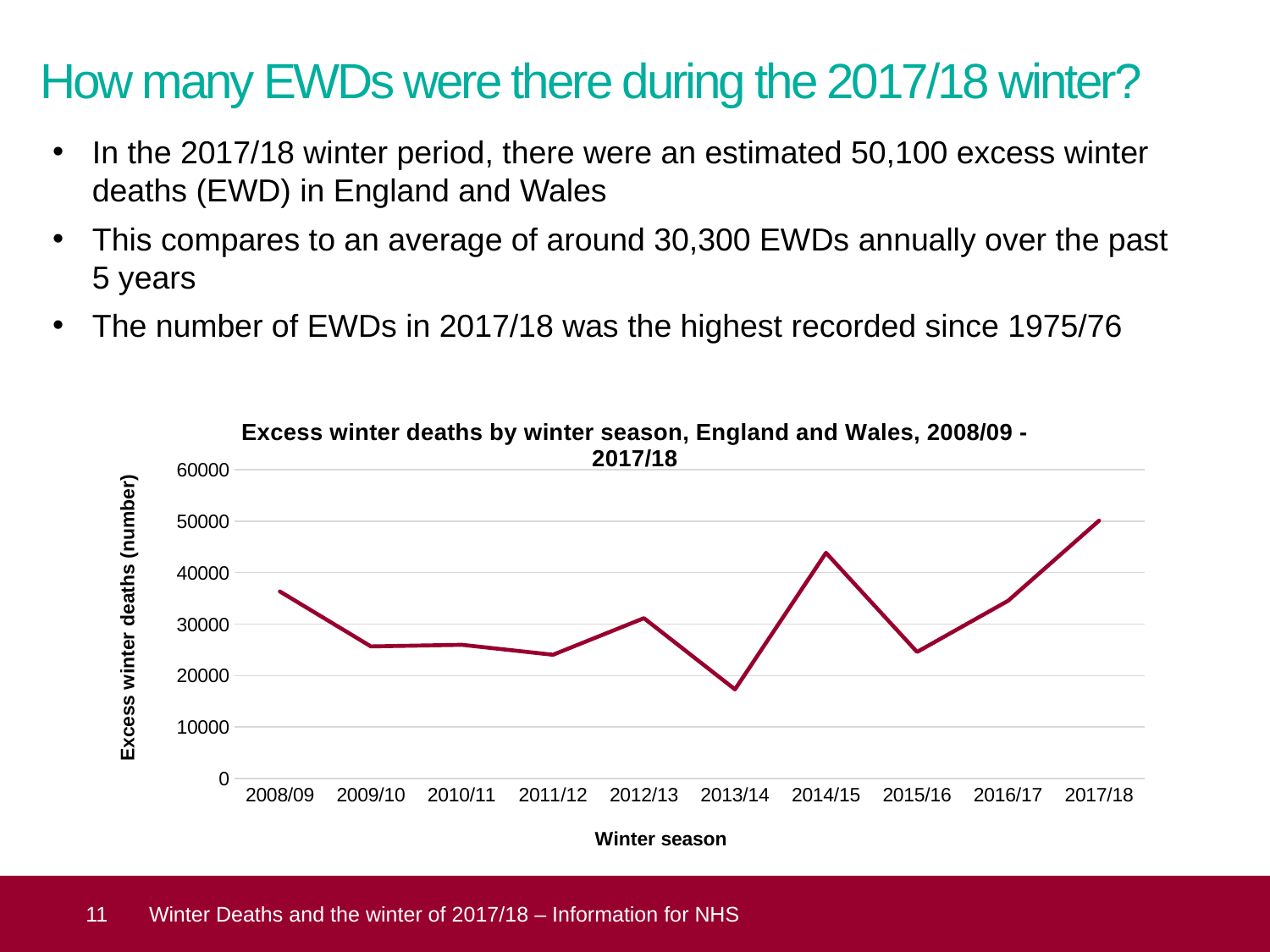
How many winter seasons are plotted on the x axis of the chart? 10 Which winter season has the lowest number of excess winter deaths in the chart? 2013/14 What is the label of the y axis of the chart? Excess winter deaths (number) Which winter season has the highest number of excess winter deaths in the chart? 2017/18 Which winter season has more excess winter deaths, 2014/15 or 2016/17? 2014/15 Which winter season has more excess winter deaths, 2008/09 or 2009/10? 2008/09 Is the value for 2017/18 greater or less than 40000? greater Do excess winter deaths rise or fall from 2015/16 to 2017/18? Rise Is the value for 2013/14 greater or less than 20000? less Is the value for 2014/15 greater or less than 40000? greater What kind of chart is shown on the slide? Line chart